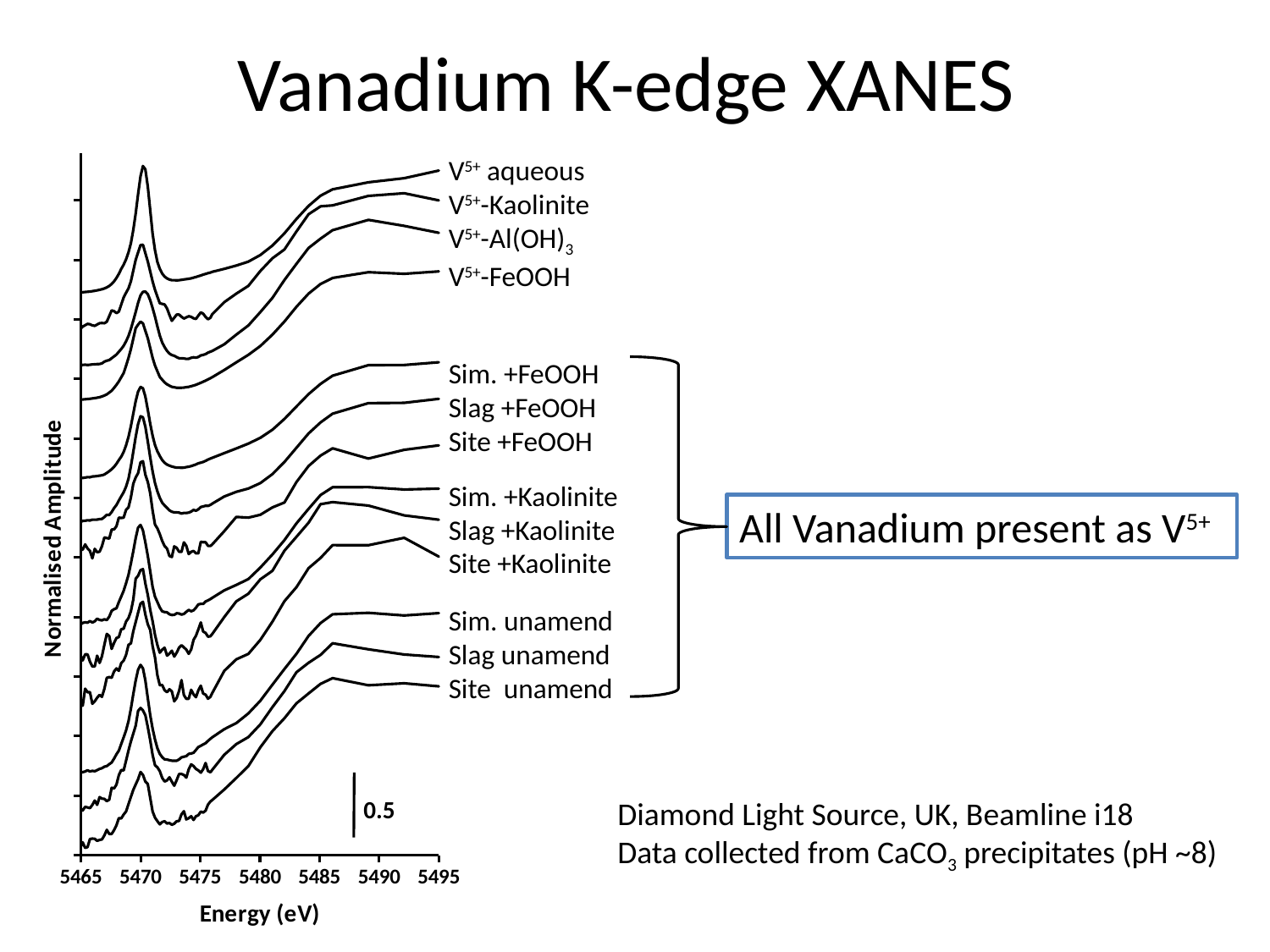
Does the amplitude of each spectrum generally rise or fall from 5475 eV to 5485 eV? Rise How many reference spectra (the V5+ standards) are plotted at the top of the chart? 4 What is the label of the y axis? Normalised Amplitude What is the lowest energy value shown on the x axis? 5465 How many sample spectra are grouped by the bracket labelled 'All Vanadium present as V5+'? 9 At which energy tick does the sharp pre-edge peak of the spectra occur? 5470 Which spectrum is plotted at the very top of the chart? V5+ aqueous What value is indicated by the vertical scale bar in the chart? 0.5 What kind of chart is shown on the slide? Line chart What is the label of the x axis? Energy (eV) What is the highest energy value shown on the x axis? 5495 How many spectra (lines) are plotted in the chart? 13